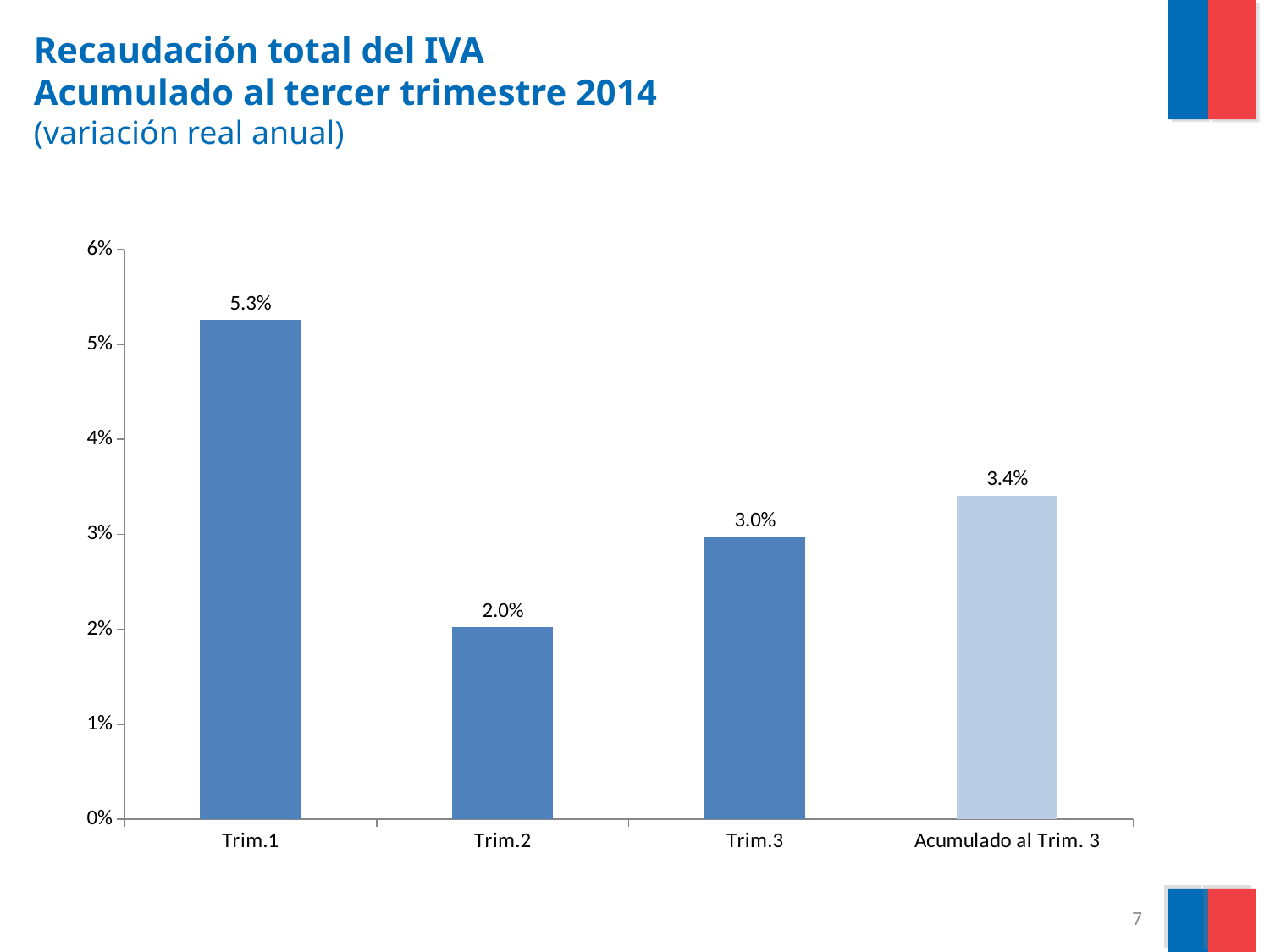
Which category has the highest value? Trim.1 What is the value for Acumulado al Trim. 3? 3.4% Which is larger, the value for Trim.3 or the value for Acumulado al Trim. 3? Acumulado al Trim. 3 What is the difference between the values for Trim.1 and Trim.2? 3.3% What is the value for Trim.1? 5.3% Which category has the lowest value? Trim.2 What kind of chart is shown on the slide? bar chart What is the value for Trim.2? 2.0% What is the value for Trim.3? 3.0% How many categories are shown on the x axis? 4 Is the value for Trim.1 greater or less than 5%? greater What is the title of the chart on the slide? Recaudación total del IVA Acumulado al tercer trimestre 2014 (variación real anual)